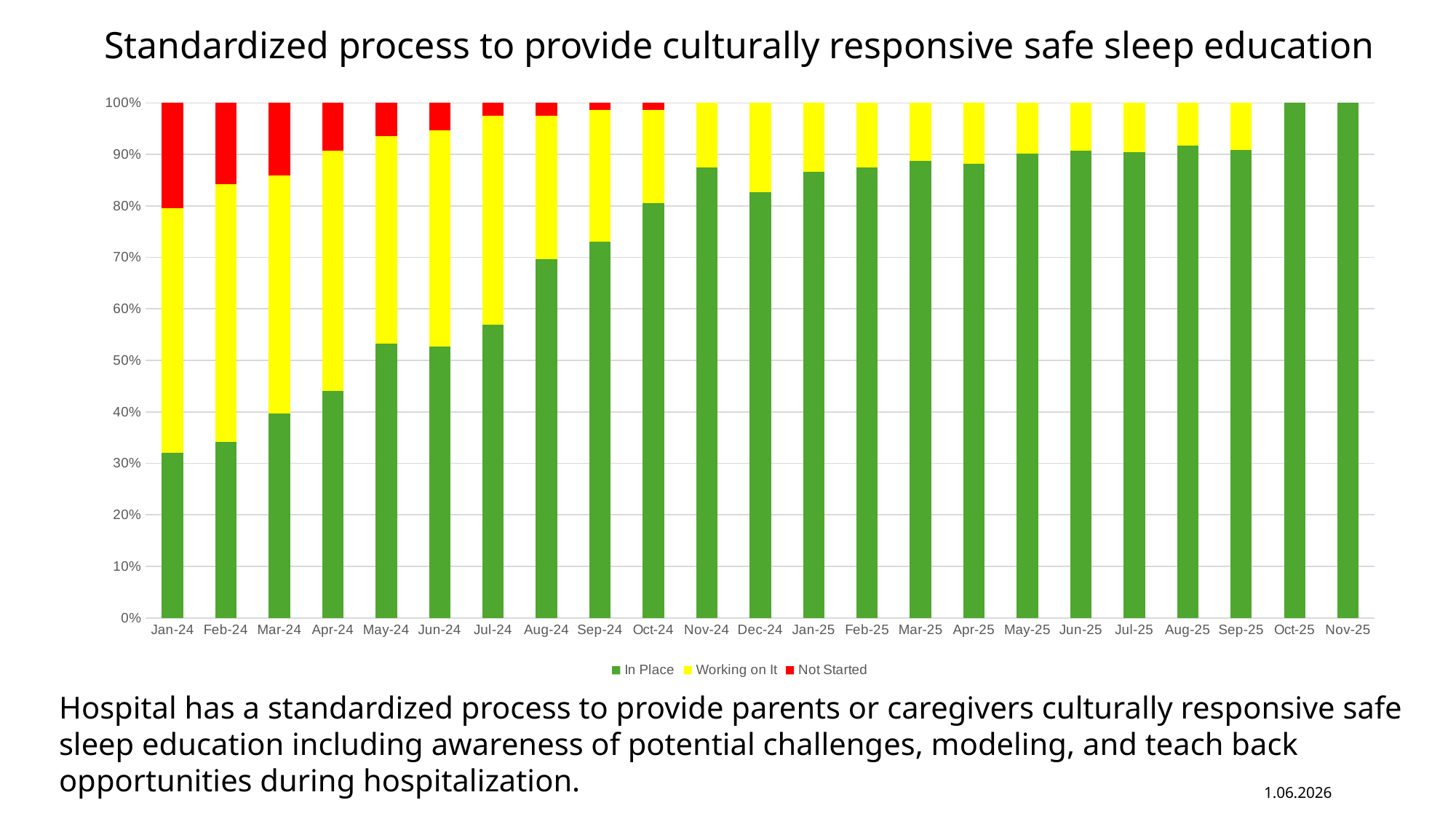
What is the In Place value for Oct-25? 100% How many months are shown on the x axis? 23 Is the In Place value for Jul-24 greater or less than 50%? greater Does the In Place share generally rise or fall from Jan-24 to Nov-25? rise Is the In Place value for Apr-24 greater or less than 50%? less What is the title of the chart? Standardized process to provide culturally responsive safe sleep education Which month has the lowest In Place share? Jan-24 Is the In Place value for Jan-24 greater or less than 40%? less What kind of chart is shown on the slide? Stacked bar chart Which is larger, the In Place share for Jan-24 or for Jun-24? Jun-24 How many series does the legend list? 3